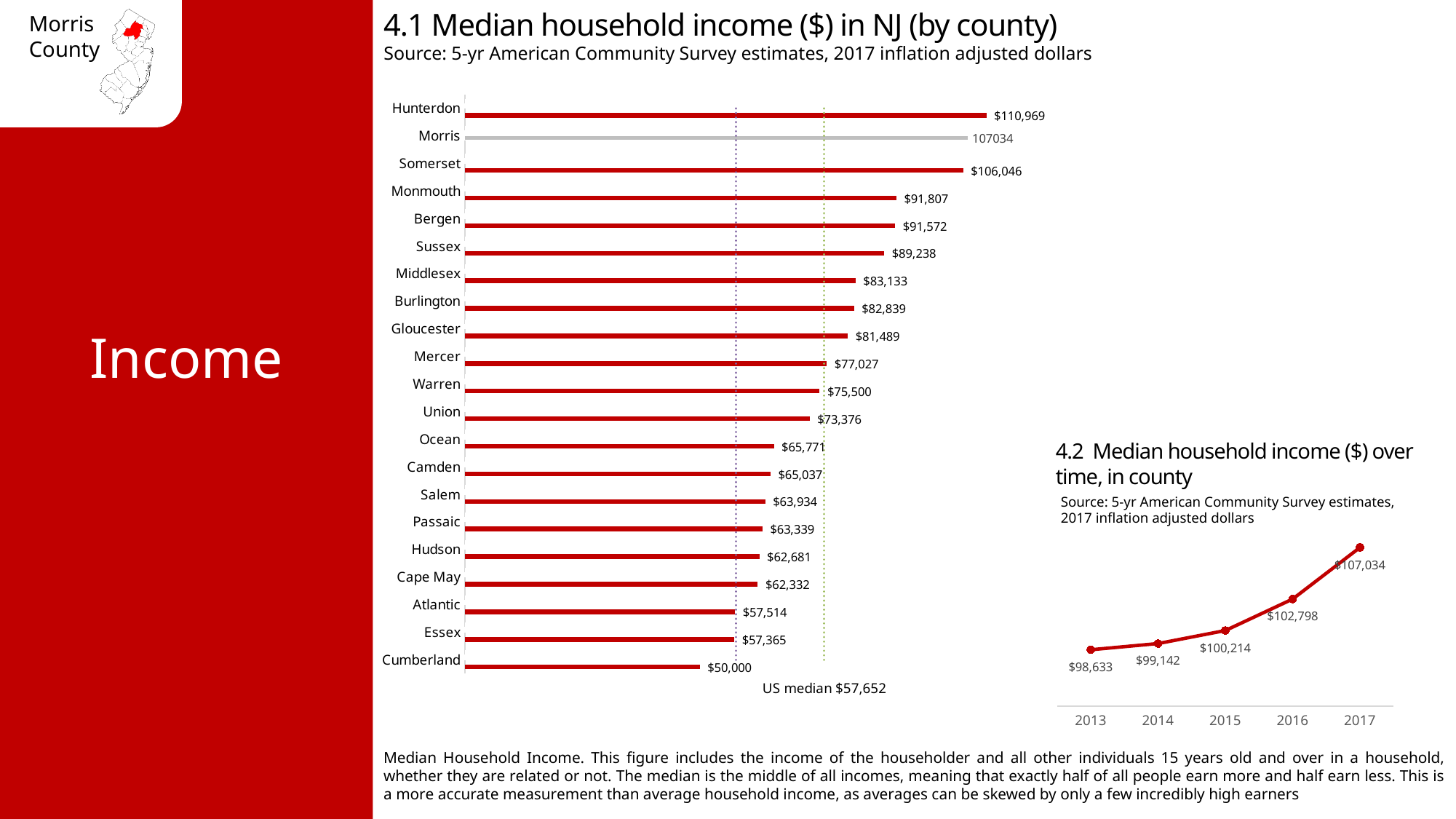
In chart 4.1, what is the median household income for Cumberland county? $50,000 In chart 4.2, what was the median household income in 2013? $98,633 In chart 4.1, what US median value is noted below the bars? $57,652 In chart 4.1, what is the median household income for Hunterdon county? $110,969 In chart 4.1, how much higher is Hunterdon's median household income than Somerset's? $4,923 In chart 4.1, how many counties are shown? 21 In chart 4.1, which county has the lowest median household income? Cumberland In chart 4.2, does the median household income rise or fall from 2013 to 2017? Rise In chart 4.1, which county has a higher median household income, Sussex or Middlesex? Sussex What kind of chart is chart 4.2? Line chart In chart 4.2, how much did the median household income increase from 2013 to 2017? $8,401 In chart 4.1, which county has the highest median household income? Hunterdon